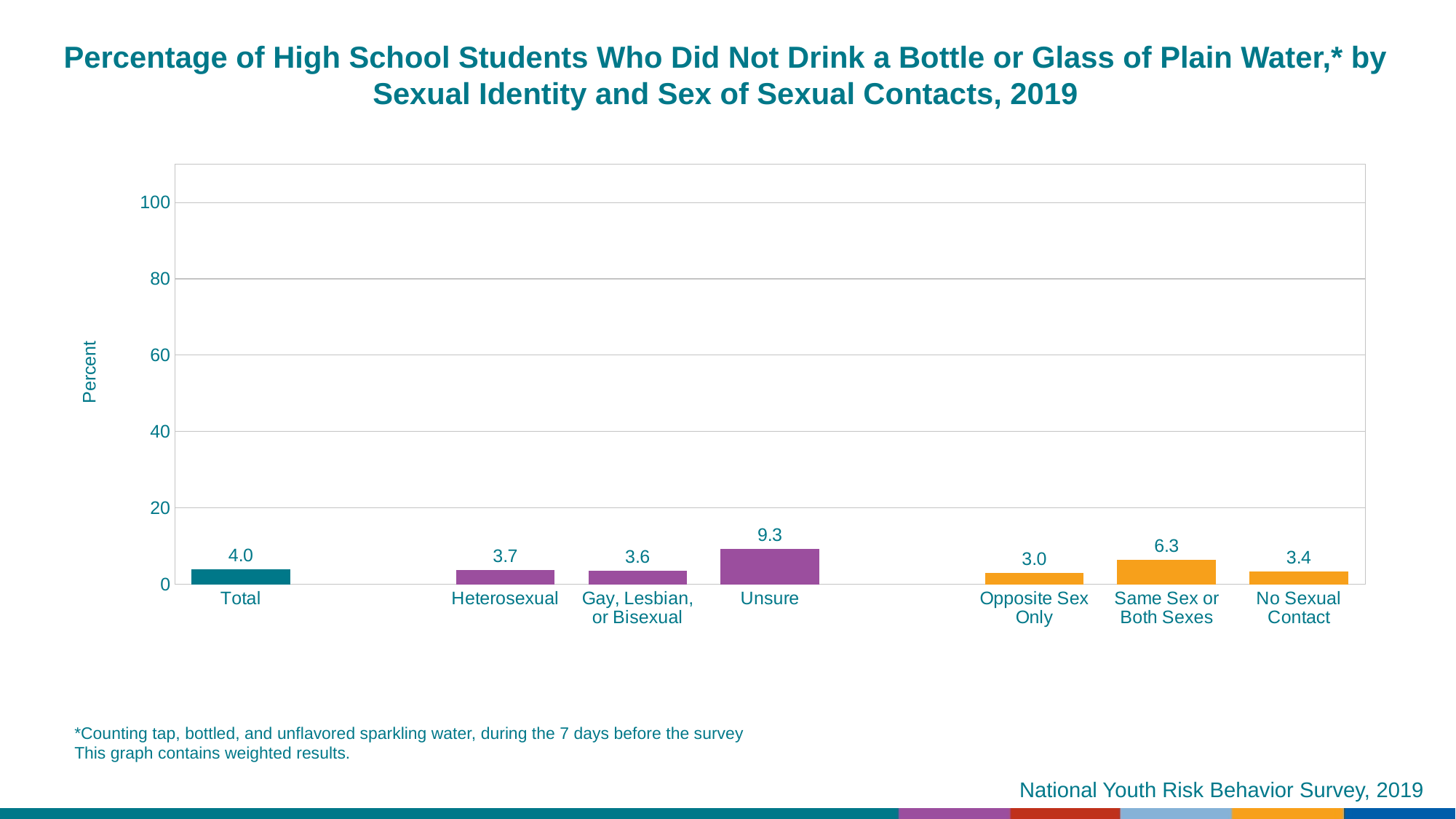
What kind of chart is shown on the slide? bar chart What is the value for Opposite Sex Only? 3.0 Which category has the lowest value? Opposite Sex Only What is the value for Total? 4.0 What is the difference between the values for Same Sex or Both Sexes and No Sexual Contact? 2.9 What is the value for Unsure? 9.3 How many categories are shown on the chart? 7 What is the difference between the values for Unsure and Heterosexual? 5.6 Is the value for Unsure greater or less than 20? less What is the value for Same Sex or Both Sexes? 6.3 Which category has the highest value? Unsure Which is larger, the value for Heterosexual or the value for Gay, Lesbian, or Bisexual? Heterosexual